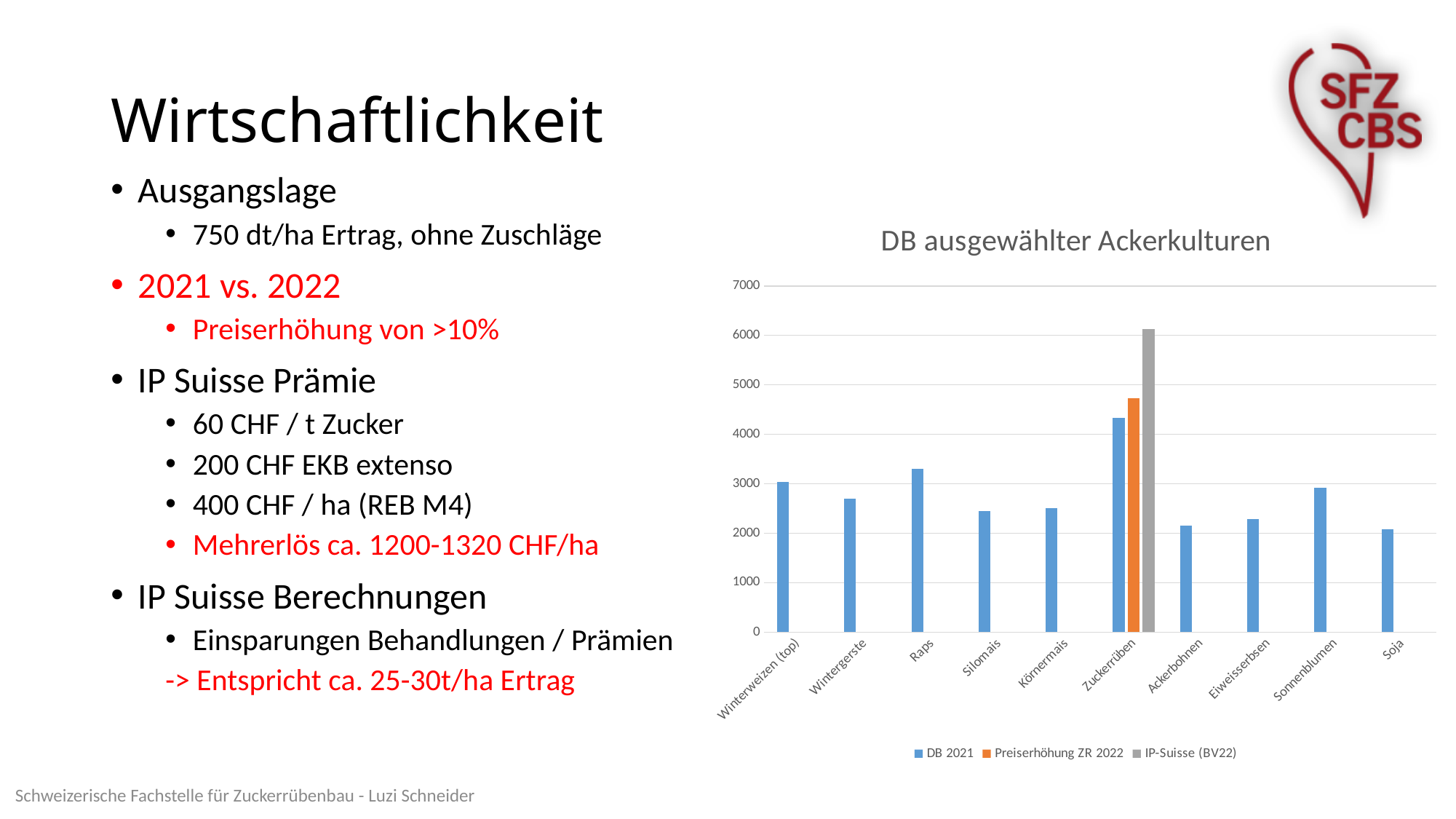
Is the DB 2021 value for Silomais greater or less than 3000? less Which crop is the only one with bars for all three series in the chart? Zuckerrüben Is the DB 2021 value for Ackerbohnen greater or less than 3000? less Which crop has the highest DB 2021 value in the chart? Zuckerrüben What kind of chart is shown on the slide? bar chart How many series does the chart legend list? 3 Is the DB 2021 value for Raps greater or less than 3000? greater What is the title of the chart? DB ausgewählter Ackerkulturen How many crop categories are shown on the x axis of the chart? 10 Which has the larger DB 2021 value, Raps or Wintergerste? Raps For Zuckerrüben, which is larger: the DB 2021 bar or the Preiserhöhung ZR 2022 bar? Preiserhöhung ZR 2022